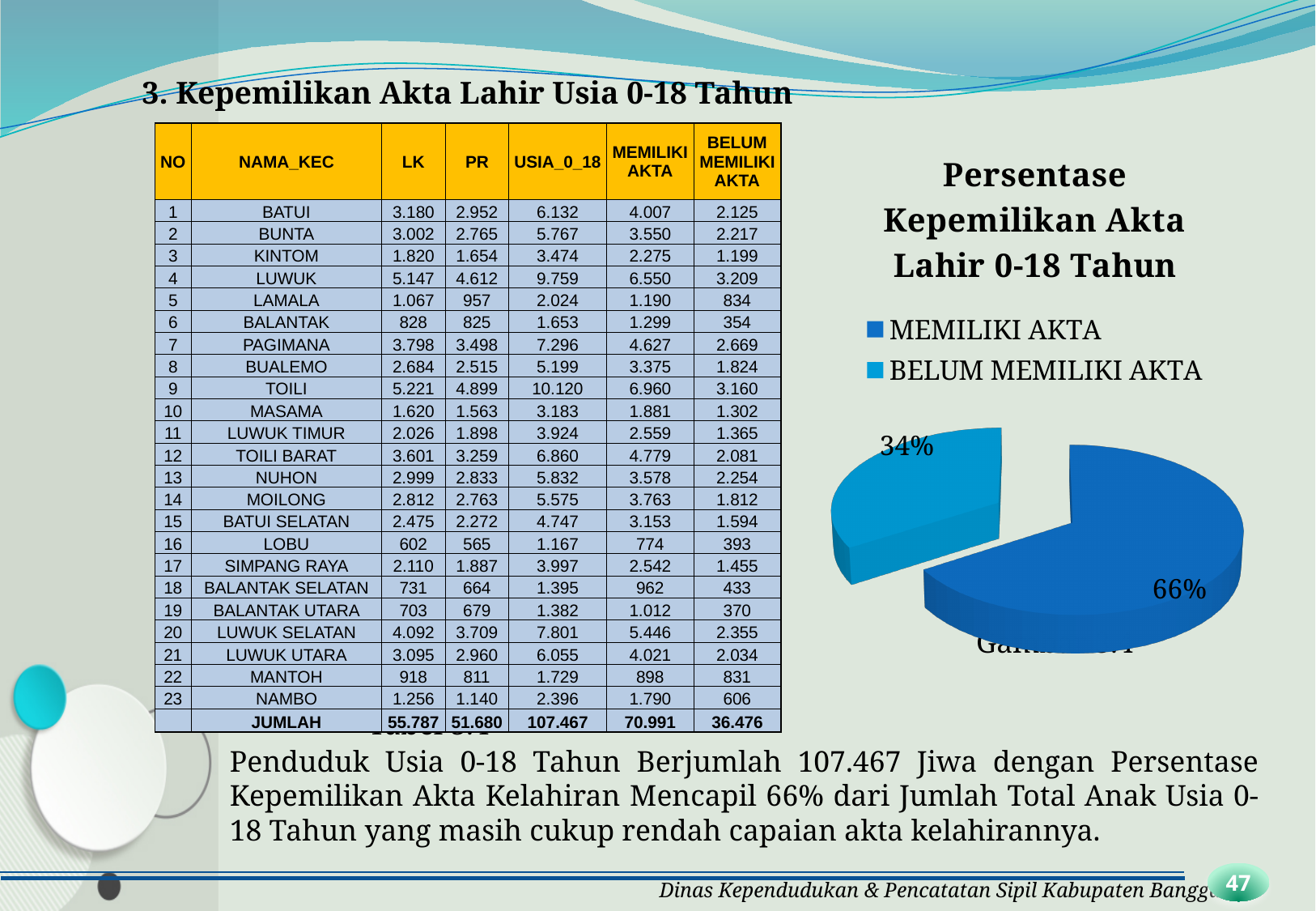
What is the title of the chart? Persentase Kepemilikan Akta Lahir 0-18 Tahun What is the difference in percentage points between the MEMILIKI AKTA slice and the BELUM MEMILIKI AKTA slice? 32% Which slice of the pie chart is the smallest? BELUM MEMILIKI AKTA What share of the pie is labelled for MEMILIKI AKTA? 66% What kind of chart is shown on the slide? pie chart Which is larger in the pie chart, MEMILIKI AKTA or BELUM MEMILIKI AKTA? MEMILIKI AKTA How many slices does the pie chart have? 2 What share of the pie is labelled for BELUM MEMILIKI AKTA? 34% What are the two legend entries of the pie chart? MEMILIKI AKTA and BELUM MEMILIKI AKTA How many entries does the chart legend list? 2 Which slice of the pie chart is the largest? MEMILIKI AKTA